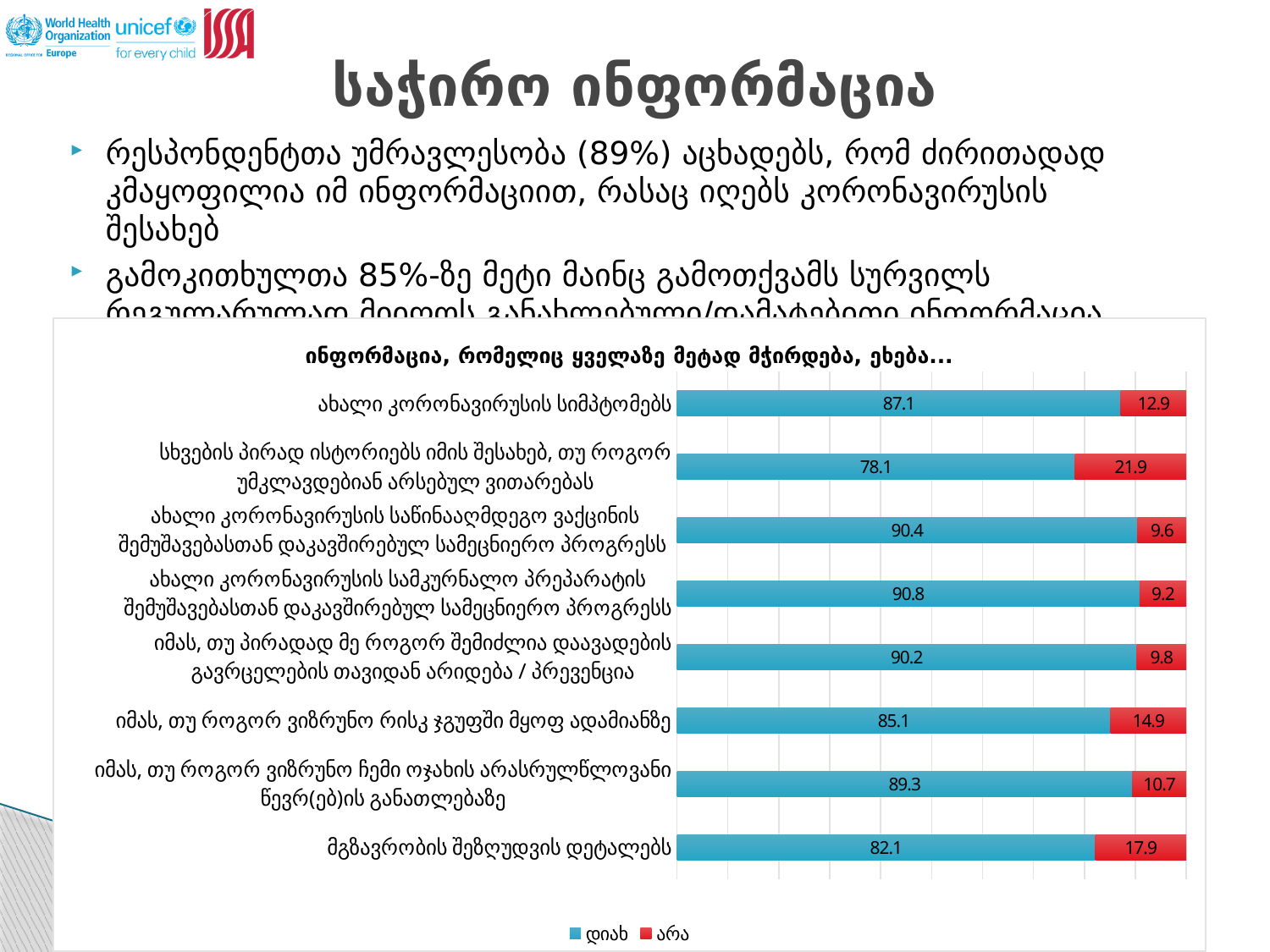
How many series does the legend list? 2 How many categories are shown in the chart? 8 Which category has the lowest დიახ value? სხვების პირად ისტორიებს იმის შესახებ, თუ როგორ უმკლავდებიან არსებულ ვითარებას What is the დიახ value for იმას, თუ როგორ ვიზრუნო რისკ ჯგუფში მყოფ ადამიანზე? 85.1 What is the დიახ value for ახალი კორონავირუსის სიმპტომებს? 87.1 What is the არა value for მგზავრობის შეზღუდვის დეტალებს? 17.9 What type of chart is shown on the slide? bar chart Which colour represents the დიახ series in the chart? blue What is the difference between the დიახ values for ახალი კორონავირუსის სიმპტომებს and მგზავრობის შეზღუდვის დეტალებს? 5.0 Which category has the highest არა value? სხვების პირად ისტორიებს იმის შესახებ, თუ როგორ უმკლავდებიან არსებულ ვითარებას Which is larger: the არა value for იმას, თუ როგორ ვიზრუნო რისკ ჯგუფში მყოფ ადამიანზე or the არა value for იმას, თუ როგორ ვიზრუნო ჩემი ოჯახის არასრულწლოვანი წევრ(ებ)ის განათლებაზე? იმას, თუ როგორ ვიზრუნო რისკ ჯგუფში მყოფ ადამიანზე Which category has the highest დიახ value? ახალი კორონავირუსის სამკურნალო პრეპარატის შემუშავებასთან დაკავშირებულ სამეცნიერო პროგრესს